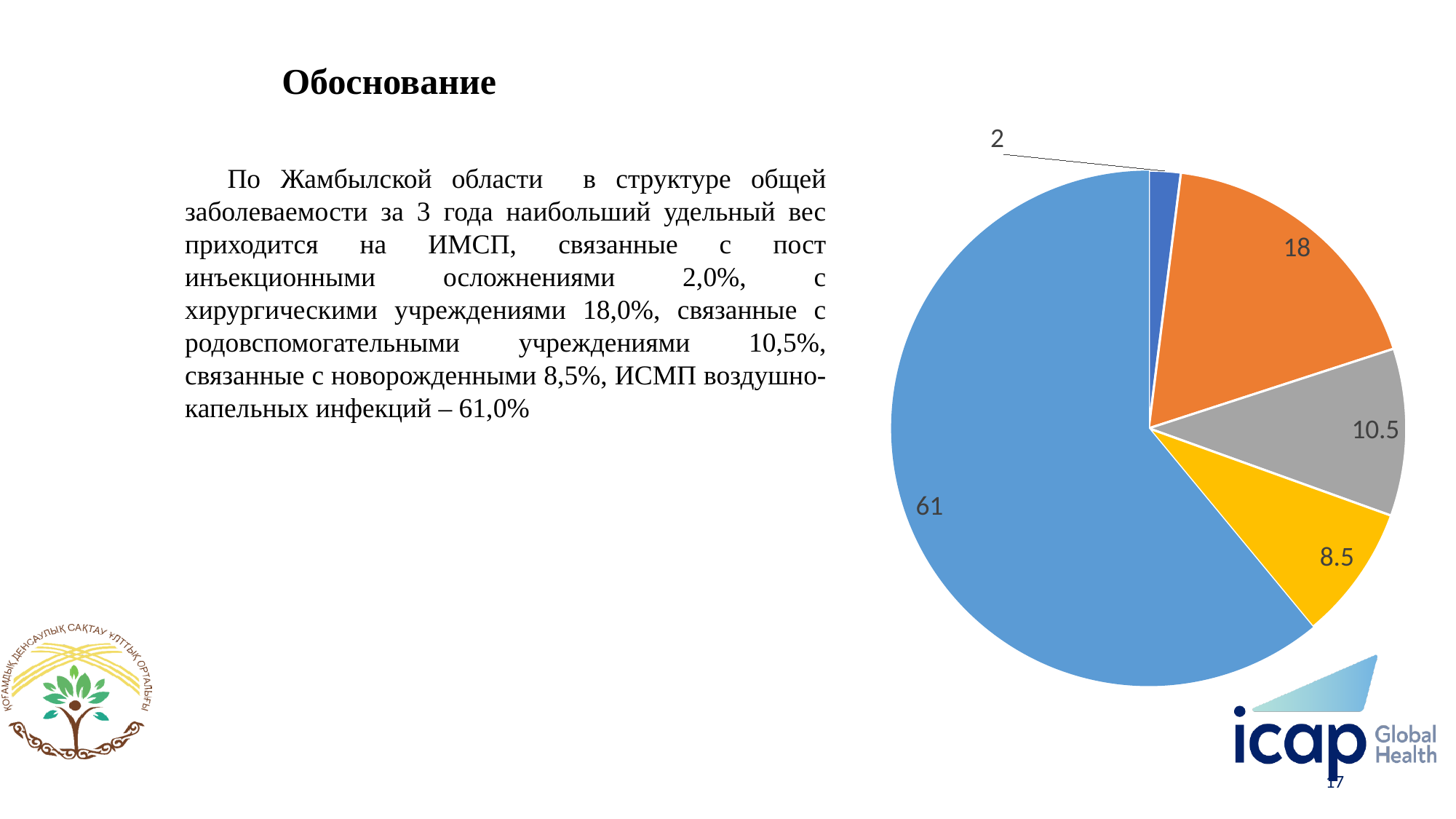
How many slices does the pie chart have? 5 What kind of chart is shown on the slide? pie chart Which is larger: the slice labelled 10.5 or the slice labelled 8.5? 10.5 What value is labelled on the yellow slice of the pie chart? 8.5 What is the difference between the slice labelled 18 and the slice labelled 10.5? 7.5 What value is labelled on the grey slice of the pie chart? 10.5 What is the largest value labelled on the pie chart? 61 What value is labelled on the orange slice of the pie chart? 18 What is the smallest value labelled on the pie chart? 2 What is the difference between the largest slice (61) and the slice labelled 18? 43 What colour is the largest slice of the pie chart? blue What is the sum of all the values labelled on the pie chart? 100